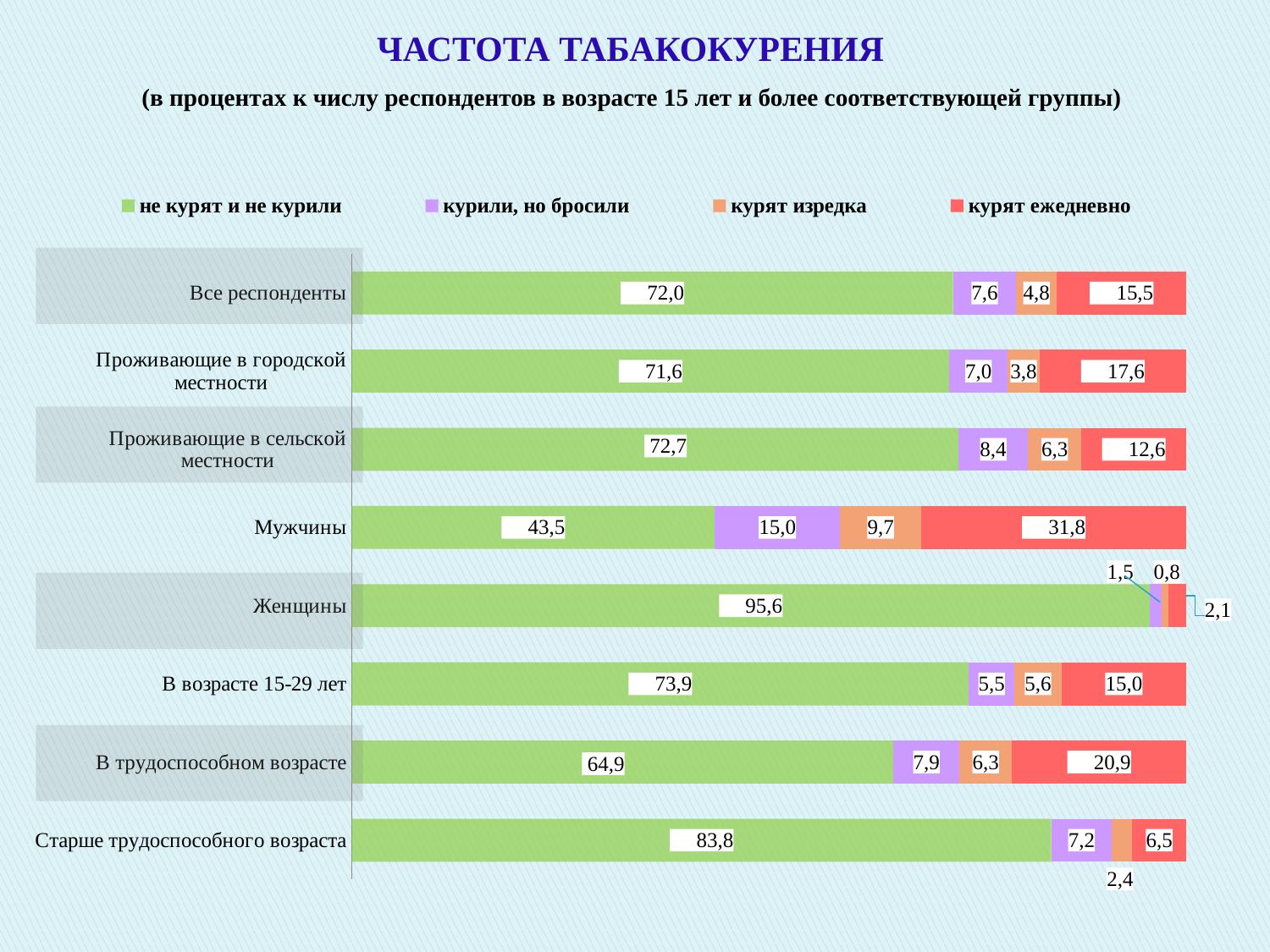
What type of chart is shown on the slide? stacked bar chart What is the value of «курят ежедневно» for «Мужчины»? 31,8 What is the value of «не курят и не курили» for «Женщины»? 95,6 Which is larger: the «курят ежедневно» value for «Проживающие в городской местности» or for «Проживающие в сельской местности»? Проживающие в городской местности How many series does the legend list? 4 What is the title of the chart? ЧАСТОТА ТАБАКОКУРЕНИЯ What is the difference between the «курят ежедневно» values for «Мужчины» and «Женщины»? 29,7 What is the value of «курили, но бросили» for «Проживающие в сельской местности»? 8,4 How many categories (groups of respondents) are shown in the chart? 8 Which category has the highest value for «курят ежедневно»? Мужчины What is the value of «курят изредка» for «Старше трудоспособного возраста»? 2,4 Which category has the lowest value for «не курят и не курили»? Мужчины